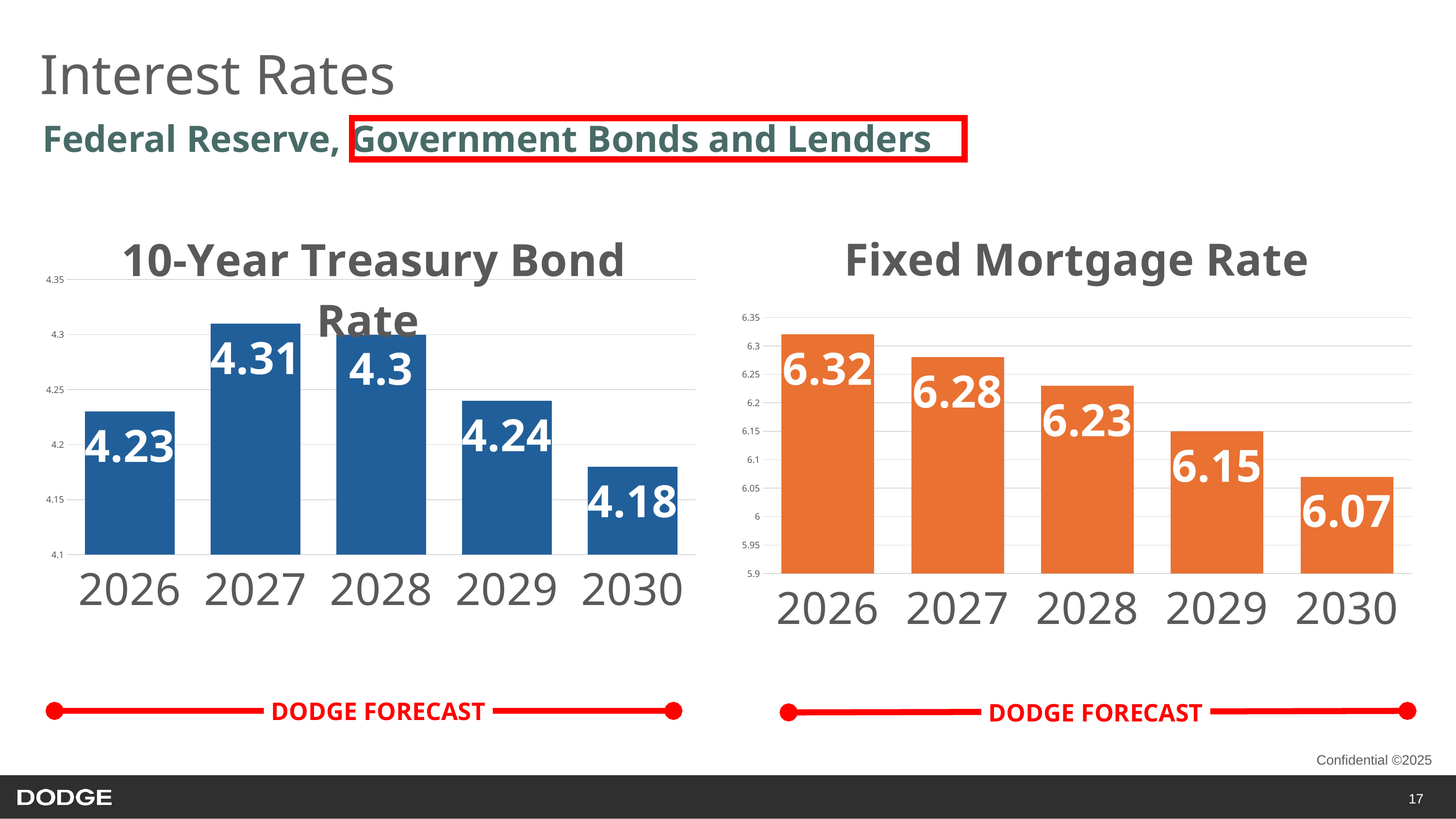
In the 10-Year Treasury Bond Rate chart, which year has the lowest value? 2030 In the 10-Year Treasury Bond Rate chart, what is the value for 2027? 4.31 In the Fixed Mortgage Rate chart, which year has the highest value? 2026 In the 10-Year Treasury Bond Rate chart, which is larger, the value for 2026 or the value for 2029? 2029 In the Fixed Mortgage Rate chart, what is the difference between the 2026 and 2030 values? 0.25 What colour are the bars in the Fixed Mortgage Rate chart? orange In the 10-Year Treasury Bond Rate chart, what is the difference between the 2027 and 2030 values? 0.13 What kind of chart is the 10-Year Treasury Bond Rate chart? bar chart In the Fixed Mortgage Rate chart, is the value for 2030 greater or less than 6.1? less In the Fixed Mortgage Rate chart, do the values rise or fall from 2026 to 2030? fall In the Fixed Mortgage Rate chart, what is the value for 2029? 6.15 How many years are shown on the x axis of the Fixed Mortgage Rate chart? 5